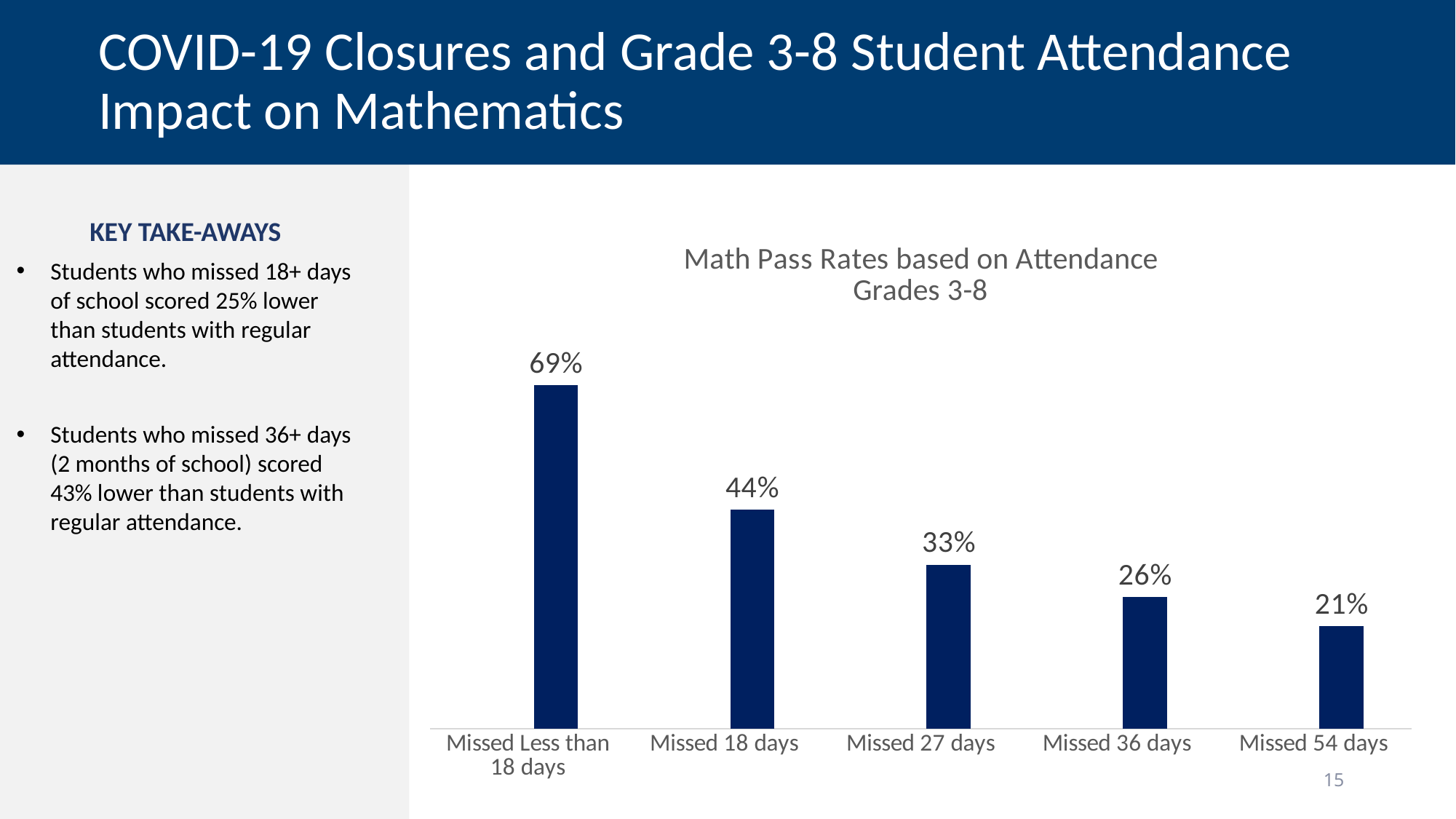
What is the math pass rate for students who missed 18 days? 44% What is the difference in math pass rate between students who missed 18 days and those who missed 27 days? 11% What is the math pass rate for students who missed 54 days? 21% Which has a higher math pass rate: students who missed 27 days or students who missed 36 days? Missed 27 days Do the math pass rates rise or fall as the number of missed days increases along the x axis? Fall Which attendance category has the highest math pass rate? Missed Less than 18 days What kind of chart is used to show the math pass rates? Bar chart Which attendance category has the lowest math pass rate? Missed 54 days What is the difference in math pass rate between students who missed less than 18 days and those who missed 36 days? 43% What is the math pass rate for students who missed 27 days? 33% What is the math pass rate for students who missed less than 18 days? 69% How many attendance categories are shown in the chart? 5